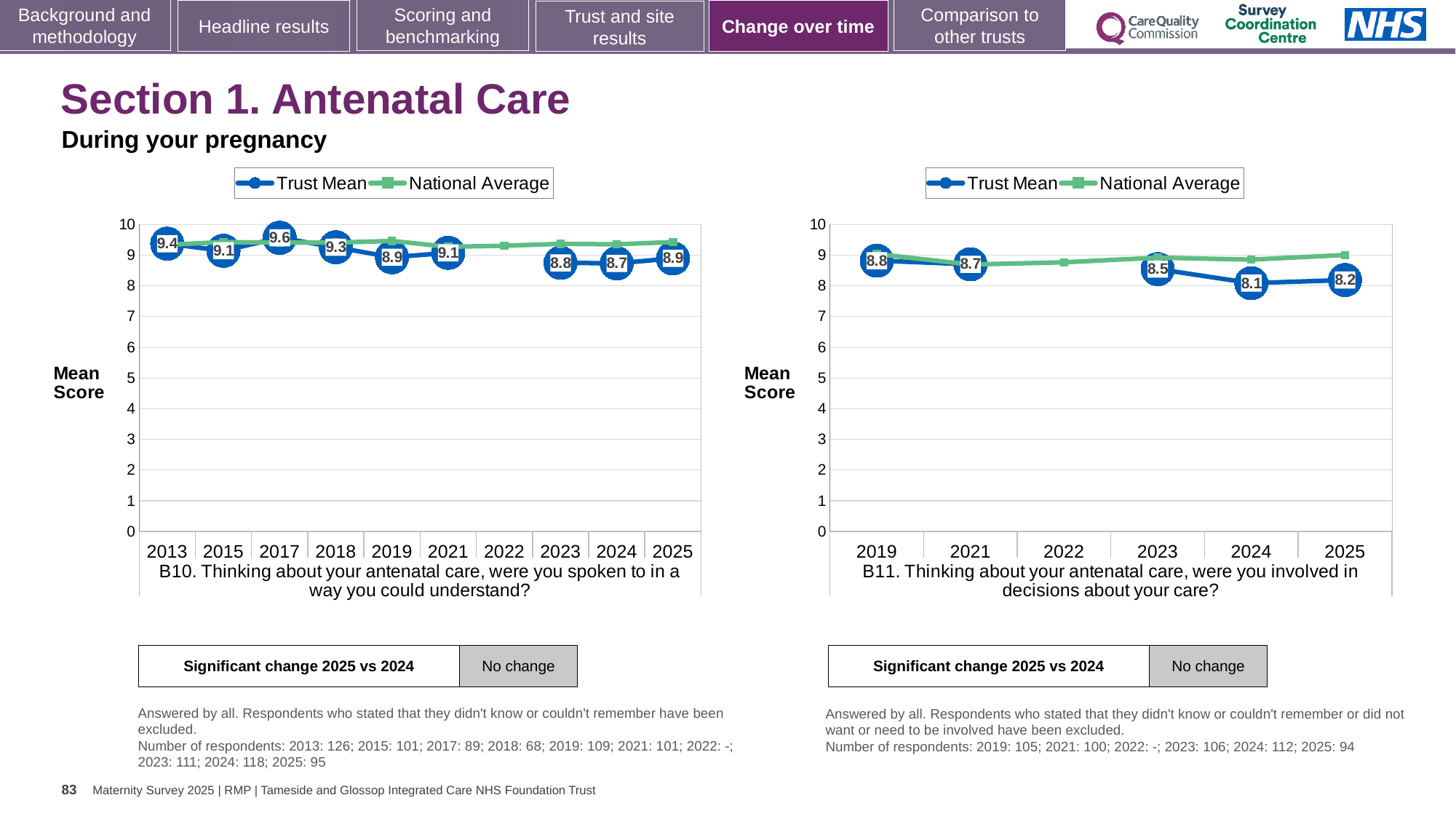
In the B11 chart, does the Trust Mean generally rise or fall from 2019 to 2024? fall In the B11 chart, what is the Trust Mean for 2024? 8.1 In the B10 chart, which year has the lowest labelled Trust Mean? 2024 In the B10 chart, which year has the highest Trust Mean? 2017 In the B11 chart, which year has the highest Trust Mean? 2019 In the B11 chart, is the Trust Mean higher in 2019 or in 2025? 2019 In the B10 chart, what is the Trust Mean for 2017? 9.6 How many series does the legend of the B10 chart list? 2 In the B10 chart, what is the Trust Mean for 2024? 8.7 In the B10 chart, what is the difference between the Trust Mean in 2017 and in 2024? 0.9 In the B11 chart, what is the difference between the Trust Mean in 2019 and in 2024? 0.7 What type of chart is the B11 chart? line chart